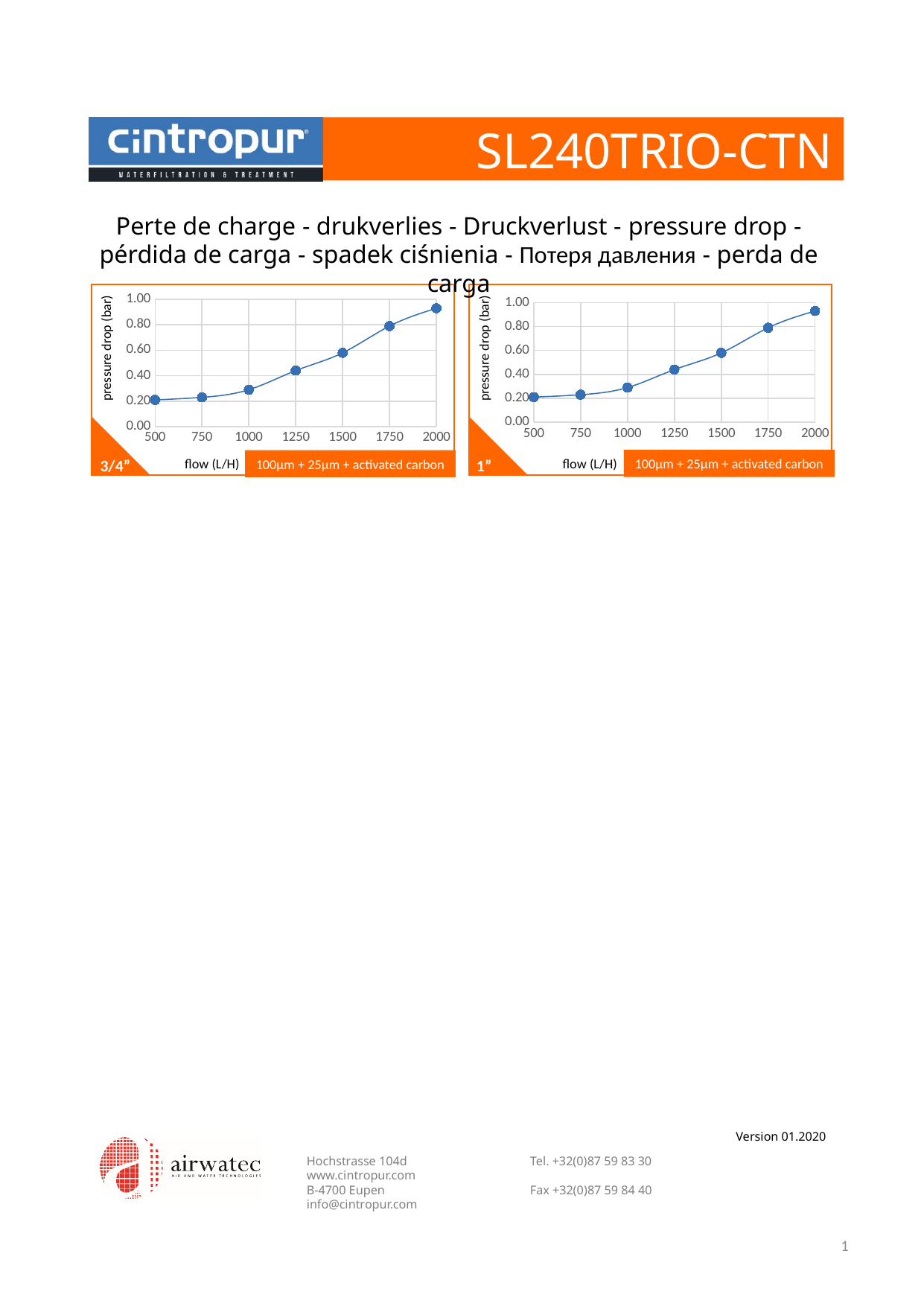
In the left chart (3/4"), which has the larger pressure drop: 750 L/H or 1500 L/H? 1500 L/H In the right chart (1"), is the pressure drop at 1000 L/H greater or less than 0.40? less In the left chart (3/4"), is the pressure drop at 1750 L/H greater or less than 0.60? greater In the right chart (1"), which has the larger pressure drop: 1000 L/H or 2000 L/H? 2000 L/H In the left chart (3/4"), how many data points are plotted? 7 In the left chart (3/4"), at which flow value is the pressure drop highest? 2000 In the right chart (1"), do the values rise or fall as flow increases from 500 to 2000 L/H? rise What is the y-axis label of the right chart (1")? pressure drop (bar) What kind of chart is the left chart (3/4")? line chart In the right chart (1"), is the pressure drop at 1250 L/H greater or less than 0.60? less